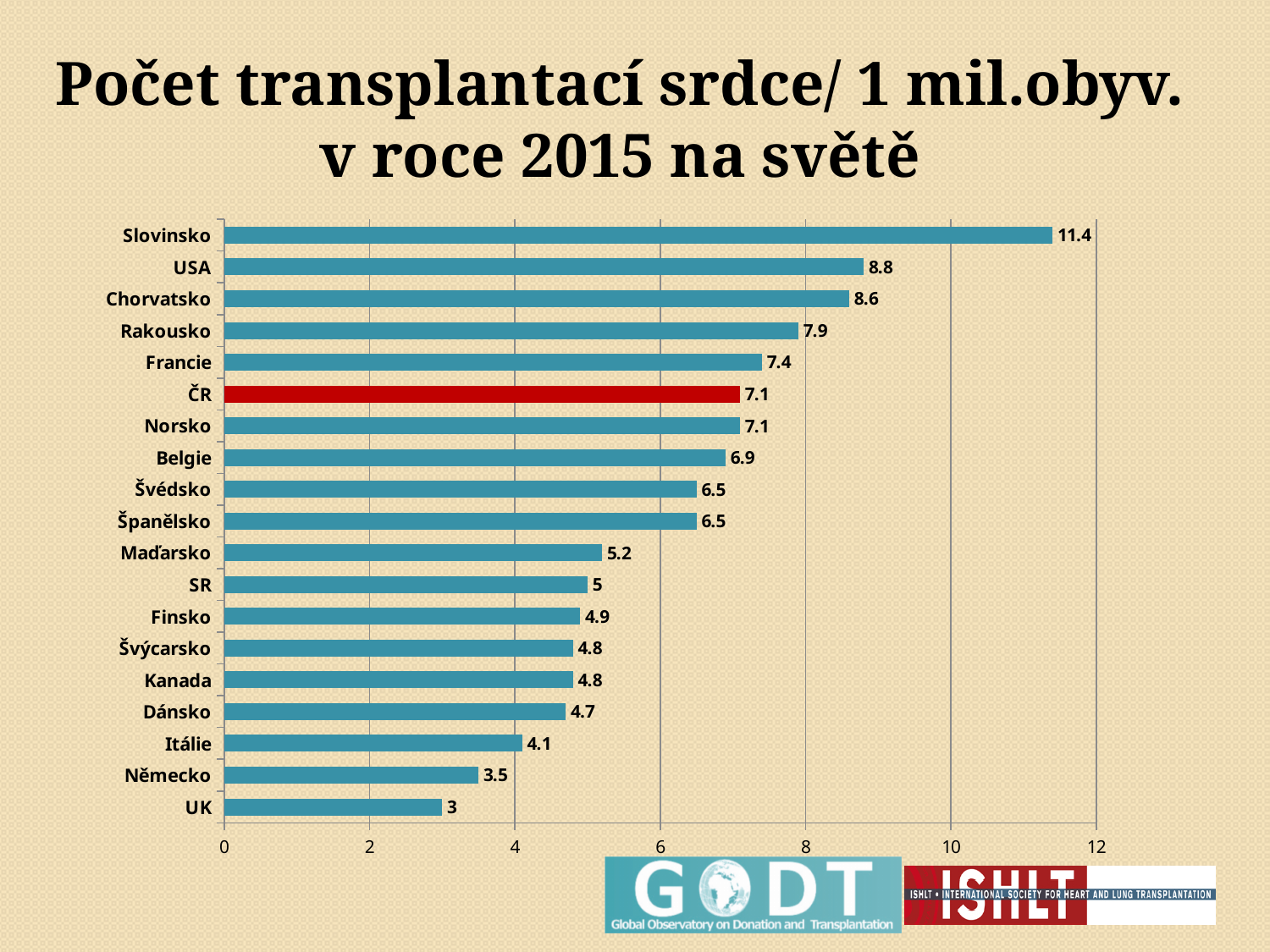
Which country has the lowest value? UK What is the value for ČR? 7.1 What is the value for Slovinsko? 11.4 How many countries are shown in the chart? 19 What is the difference between the values for USA and Chorvatsko? 0.2 Which country's bar is highlighted in red? ČR Which is larger, the value for Rakousko or the value for Francie? Rakousko Is the value for Maďarsko greater or less than 6? less What is the value for Německo? 3.5 What is the difference between the values for Slovinsko and UK? 8.4 Which country has the highest value? Slovinsko What kind of chart is shown on the slide? bar chart